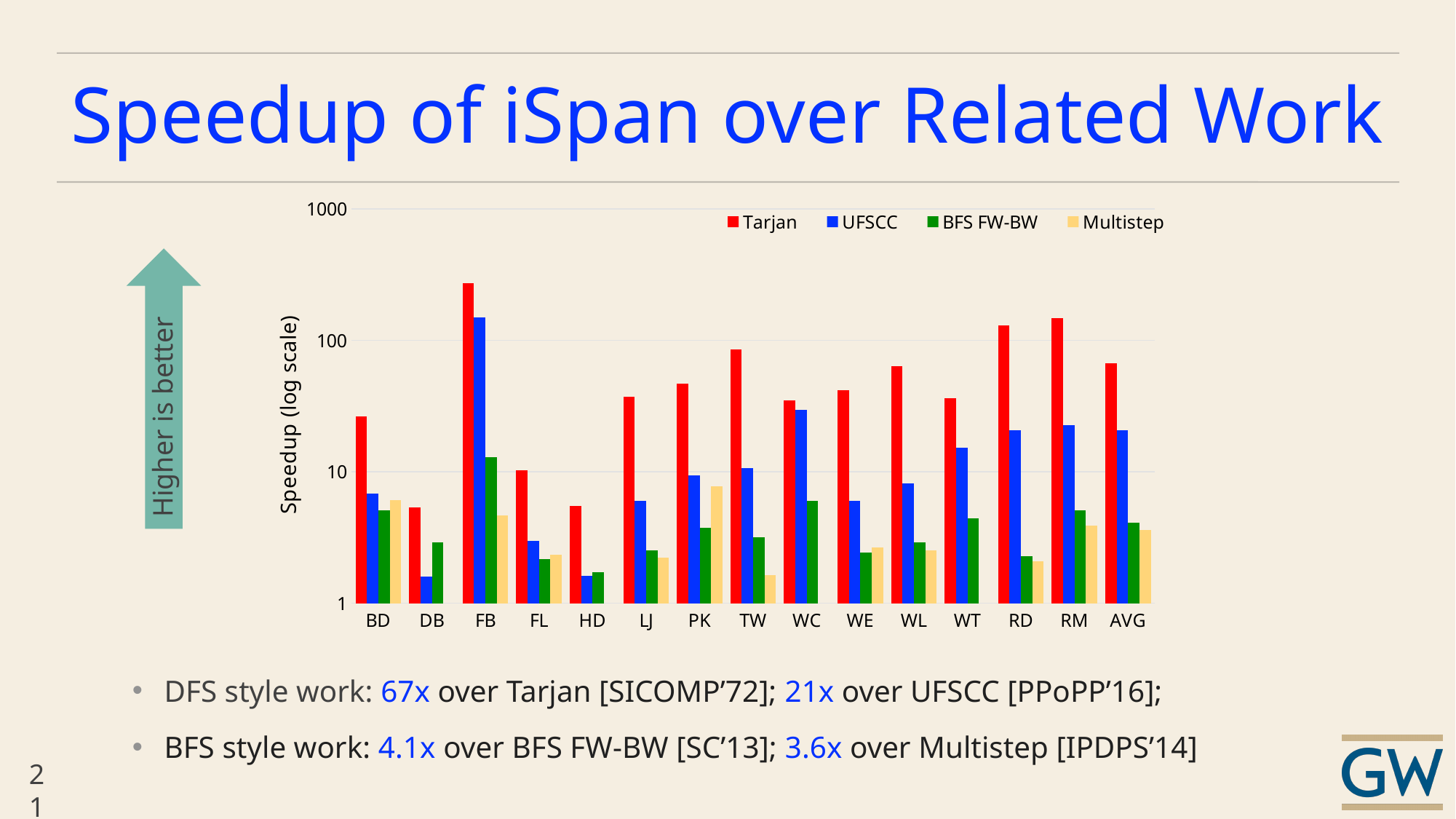
Is the UFSCC value for DB greater or less than 10? less Which is larger for PK, the Multistep value or the BFS FW-BW value? Multistep Is the Tarjan value for BD greater or less than 100? less Is the Tarjan value for FB greater or less than 100? greater What kind of chart is shown on the slide? bar chart How many categories are shown along the x axis of the chart? 15 Which is larger for RM, the Tarjan value or the UFSCC value? Tarjan What is the title of the chart's y axis? Speedup (log scale) For which category is the Tarjan speedup highest? FB How many series does the chart legend list? 4